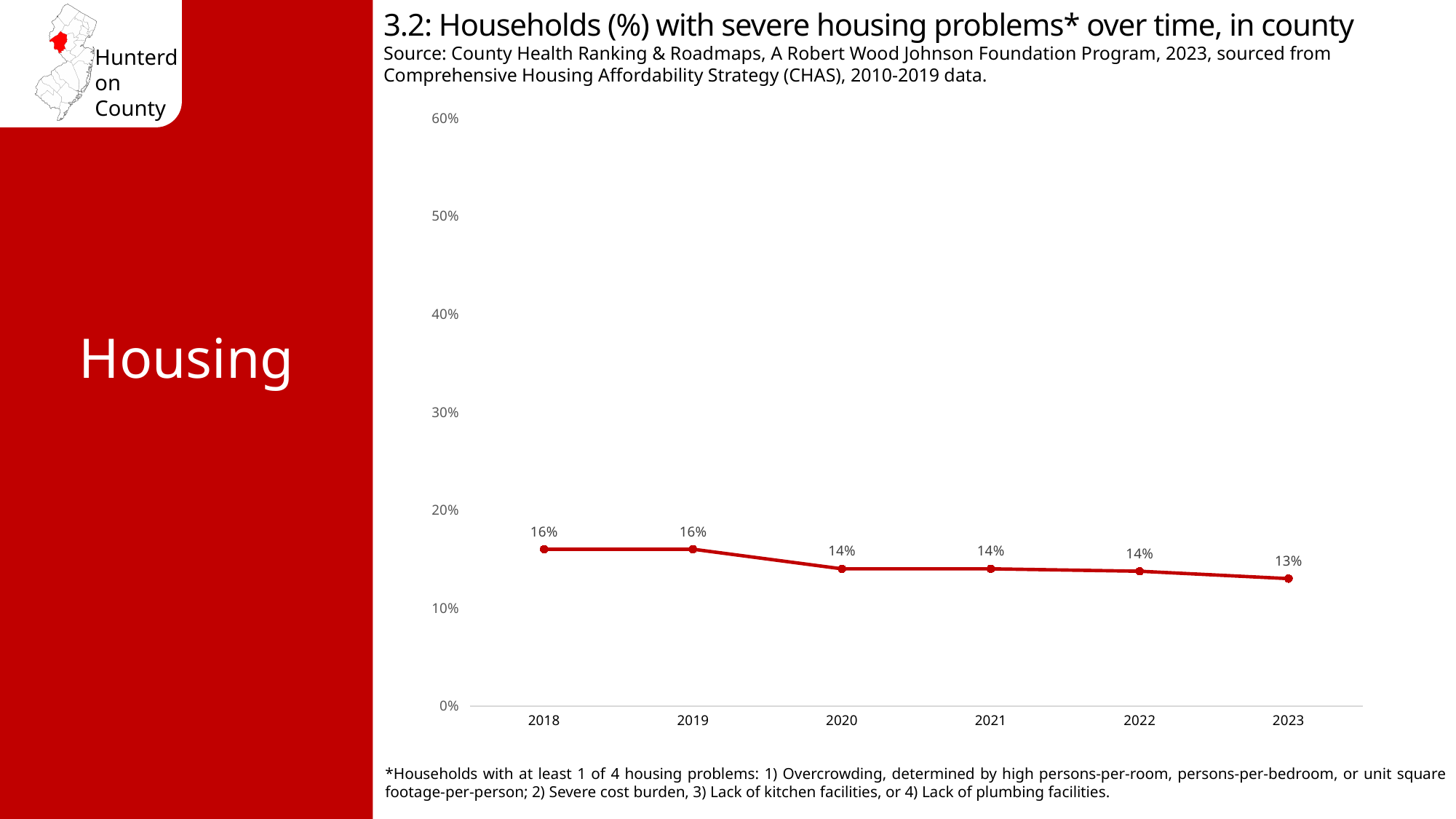
How many years are plotted on the chart? 6 Is the value for 2019 greater or less than 20%? less What is the value shown for 2022? 14% What kind of chart is shown on the slide? line chart Do the values rise or fall from 2018 to 2023? fall What is the title of the chart? 3.2: Households (%) with severe housing problems* over time, in county Which is larger, the value for 2019 or the value for 2021? 2019 What is the value shown for 2020? 14% What percentage of households had severe housing problems in 2018? 16% Which year has the lowest percentage of households with severe housing problems? 2023 What percentage of households had severe housing problems in 2023? 13% What is the difference between the 2018 value and the 2023 value? 3%